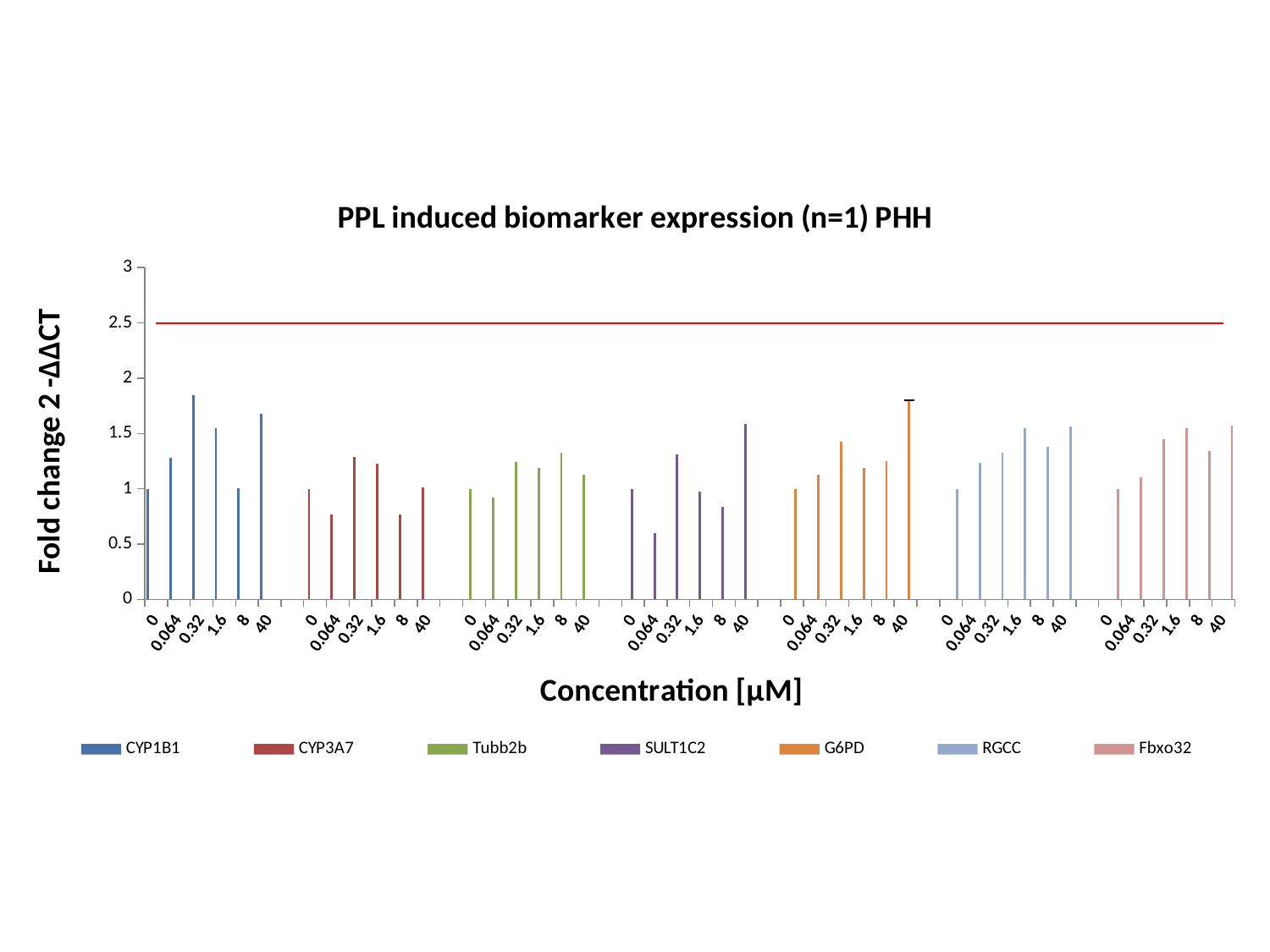
At which concentration is the G6PD value highest? 40 At what fold change value is the horizontal red line drawn? 2.5 How many series does the legend list? 7 Is the value for CYP1B1 at 0.32 µM greater or less than 1.5? greater How many concentration levels are plotted for each biomarker series? 6 What kind of chart is shown on the slide? bar chart Is the value for SULT1C2 at 0.064 µM greater or less than 1? less What is the title of the chart? PPL induced biomarker expression (n=1) PHH At which concentration is the SULT1C2 value lowest? 0.064 Is the value for Fbxo32 at 8 µM greater or less than 1? greater Which is larger: the SULT1C2 value at 40 µM or the SULT1C2 value at 0.064 µM? 40 µM